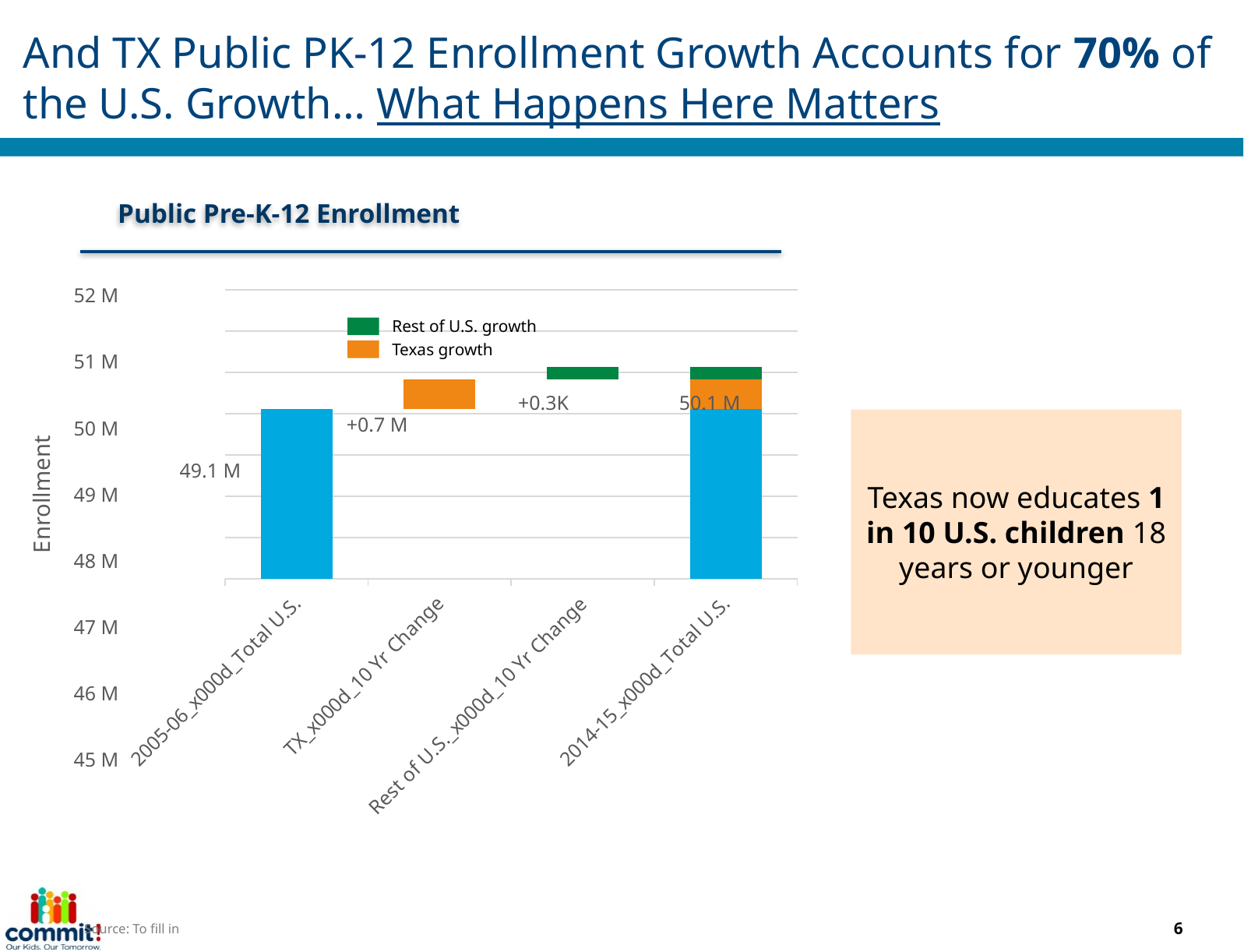
Which legend entry is shown in orange? Texas growth What is the value labeled for the TX 10 Yr Change bar? +0.7 M What is the value labeled for the Rest of U.S. 10 Yr Change bar? +0.3K Which category has the highest total enrollment value? 2014-15 Total U.S. How many categories are shown on the x axis of the chart? 4 Which is larger, the TX 10 Yr Change or the Rest of U.S. 10 Yr Change? TX 10 Yr Change What is the value shown for 2005-06 Total U.S. enrollment? 49.1 M How many series does the chart legend list? 2 What kind of chart is shown on the slide? Bar chart What is the value shown for 2014-15 Total U.S. enrollment? 50.1 M What is the title of the chart? Public Pre-K-12 Enrollment What is the difference between the 2014-15 Total U.S. and the 2005-06 Total U.S. enrollment values? 1.0 M